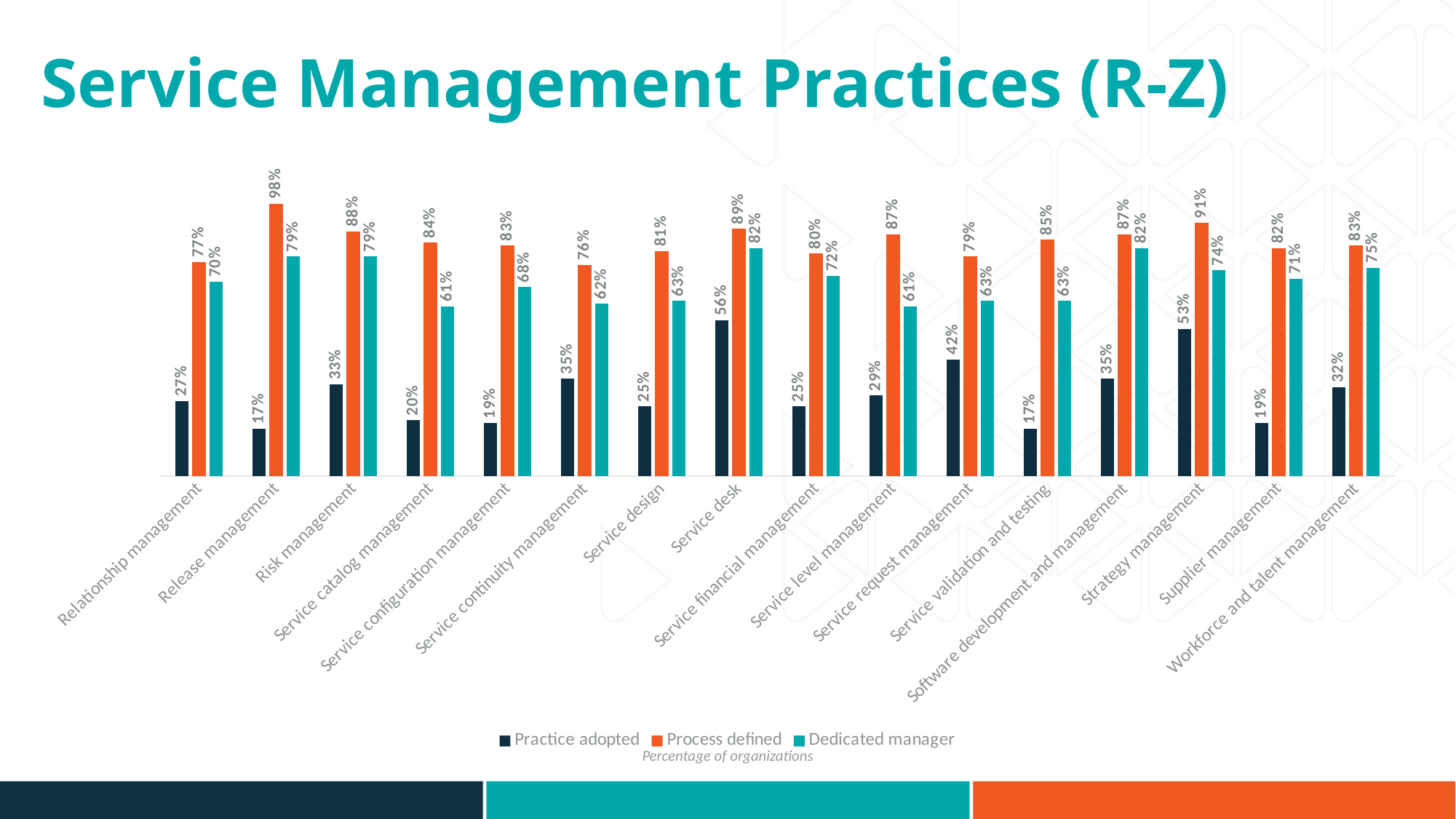
Which is larger for Service request management: the Practice adopted value or the Dedicated manager value? Dedicated manager What is the Process defined value for Release management? 98% Which category has the highest Practice adopted value? Service desk What kind of chart is shown on the slide? Bar chart What is the title of the slide? Service Management Practices (R-Z) Which category has the highest Process defined value? Release management How many series does the legend list? 3 What is the Practice adopted value for Service desk? 56% How many categories are shown on the x axis? 16 Which category has the lowest Process defined value? Service continuity management What is the Dedicated manager value for Strategy management? 74% What is the difference between the Process defined and Practice adopted values for Release management? 81%